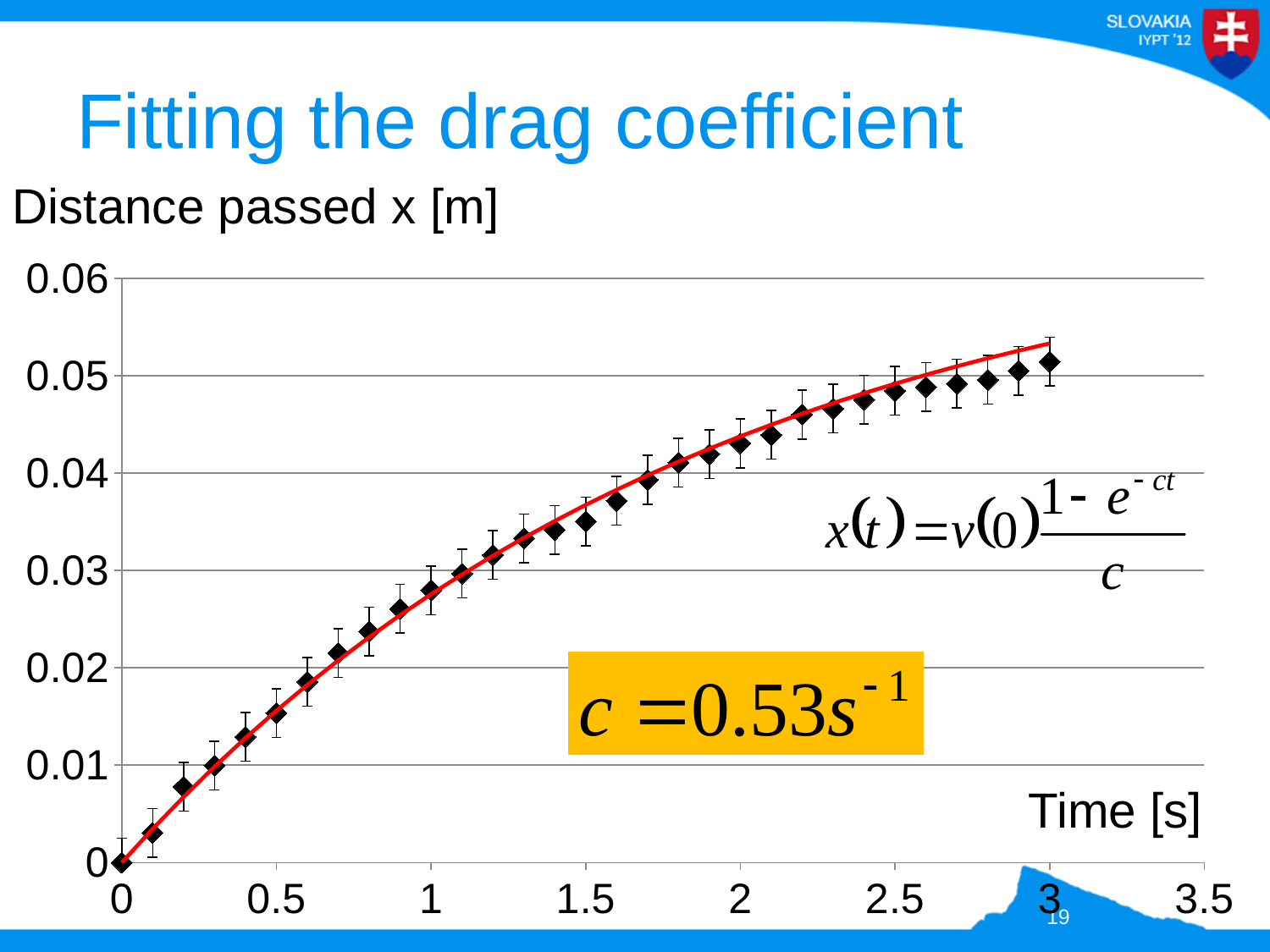
Is the distance passed at time 1.5 s greater or less than 0.04? less What is the title of the slide containing the chart? Fitting the drag coefficient At which time is the plotted distance passed the highest? 3 s Is the distance passed at time 0.5 s greater or less than 0.02? less Is the distance passed at time 1 s greater or less than 0.02? greater Which is larger, the distance passed at 1 s or at 2 s? 2 s What kind of chart is shown on the slide? scatter plot with a fitted curve What is the label of the vertical axis? Distance passed x [m] Do the plotted distance values rise or fall as time increases? rise What is the distance passed at time 0 s? 0